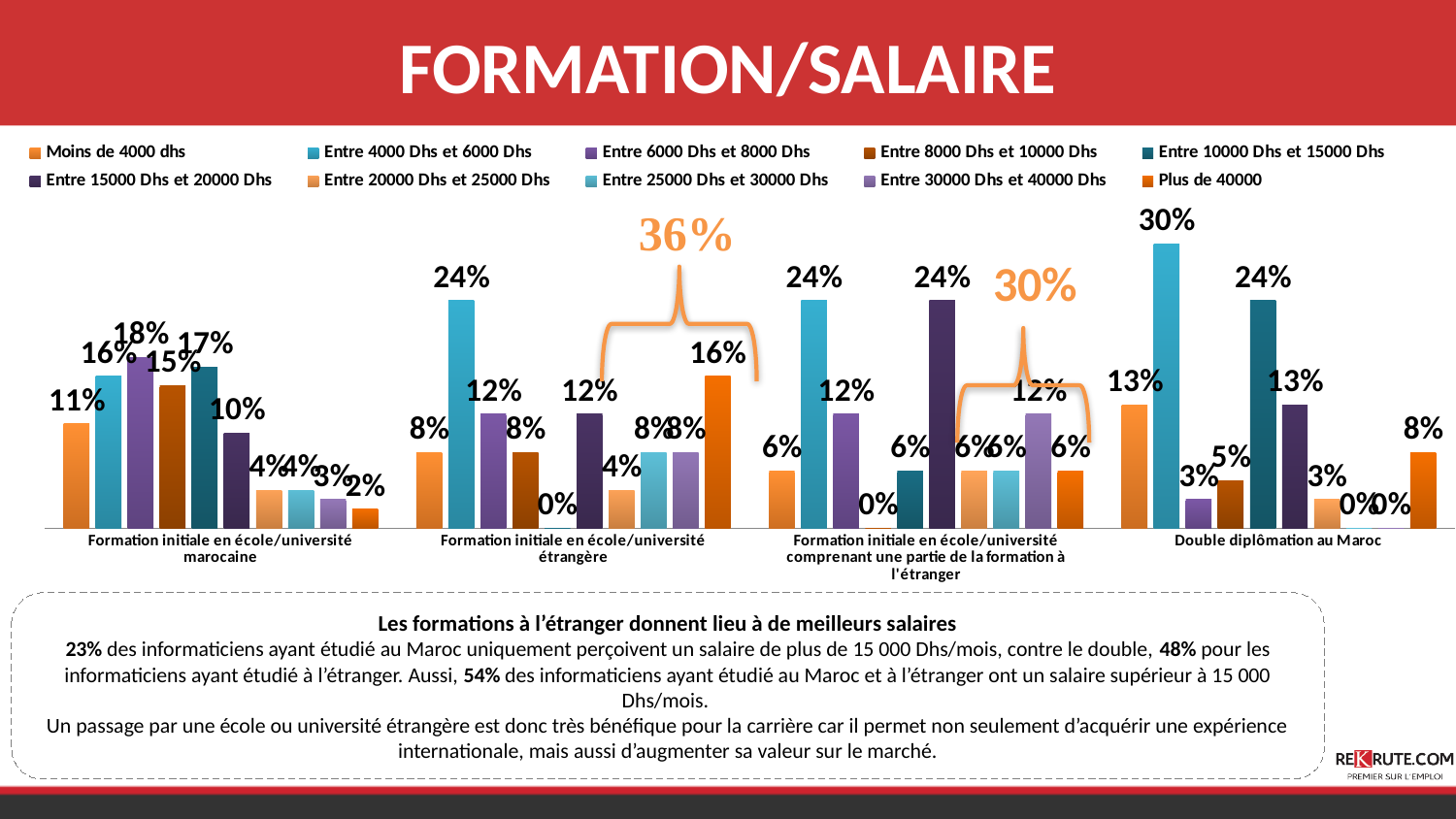
What kind of chart is shown on the slide? Bar chart Which salary range has the highest value in the 'Double diplômation au Maroc' category? Entre 4000 Dhs et 6000 Dhs How many salary ranges does the legend list? 10 What is the value for 'Entre 10000 Dhs et 15000 Dhs' in the 'Formation initiale en école/université étrangère' category? 0% What is the value for 'Entre 4000 Dhs et 6000 Dhs' in the 'Double diplômation au Maroc' category? 30% What is the title of the slide containing the chart? FORMATION/SALAIRE Which salary range has the highest value in the 'Formation initiale en école/université marocaine' category? Entre 6000 Dhs et 8000 Dhs What is the value for 'Plus de 40000' in the 'Formation initiale en école/université étrangère' category? 16% For 'Moins de 4000 dhs', which category has the larger value: 'Formation initiale en école/université marocaine' or 'Formation initiale en école/université étrangère'? Formation initiale en école/université marocaine What is the value for 'Moins de 4000 dhs' in the 'Formation initiale en école/université marocaine' category? 11% In the 'Double diplômation au Maroc' category, what is the difference between the values for 'Entre 4000 Dhs et 6000 Dhs' and 'Entre 10000 Dhs et 15000 Dhs'? 6 percentage points How many training categories are shown along the x axis? 4